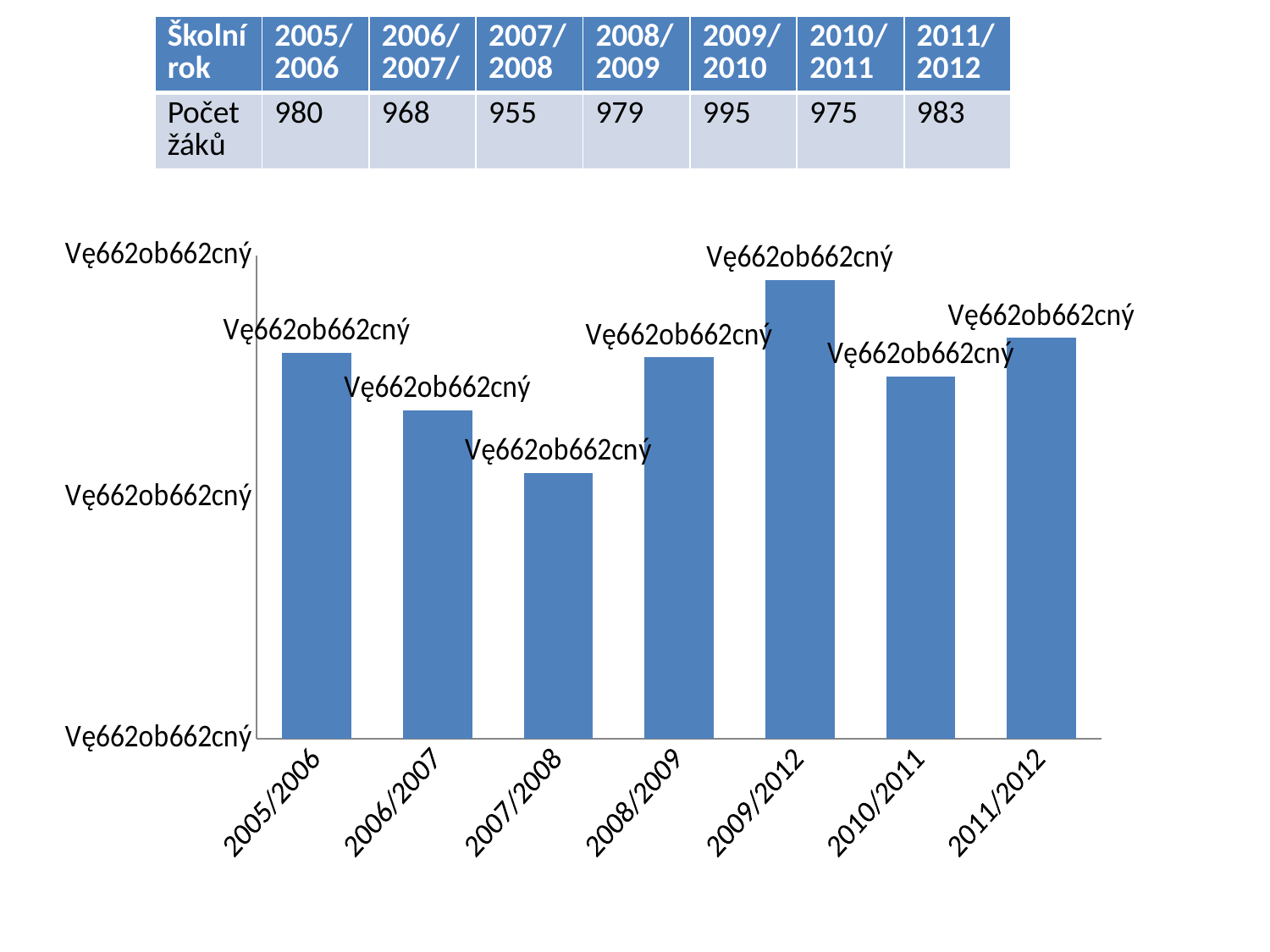
Which bar is taller, 2009/2012 or 2011/2012? 2009/2012 What kind of chart is shown on the slide? bar chart Do the bars rise or fall from 2005/2006 to 2007/2008? fall What colour are the bars in the chart? blue Do the bars rise or fall from 2007/2008 to 2009/2012? rise Which bar is taller, 2005/2006 or 2006/2007? 2005/2006 What is the label of the first category on the x axis of the chart? 2005/2006 Which category has the shortest bar in the chart? 2007/2008 Which category has the tallest bar in the chart? 2009/2012 Which bar is taller, 2007/2008 or 2010/2011? 2010/2011 How many bars does the chart have? 7